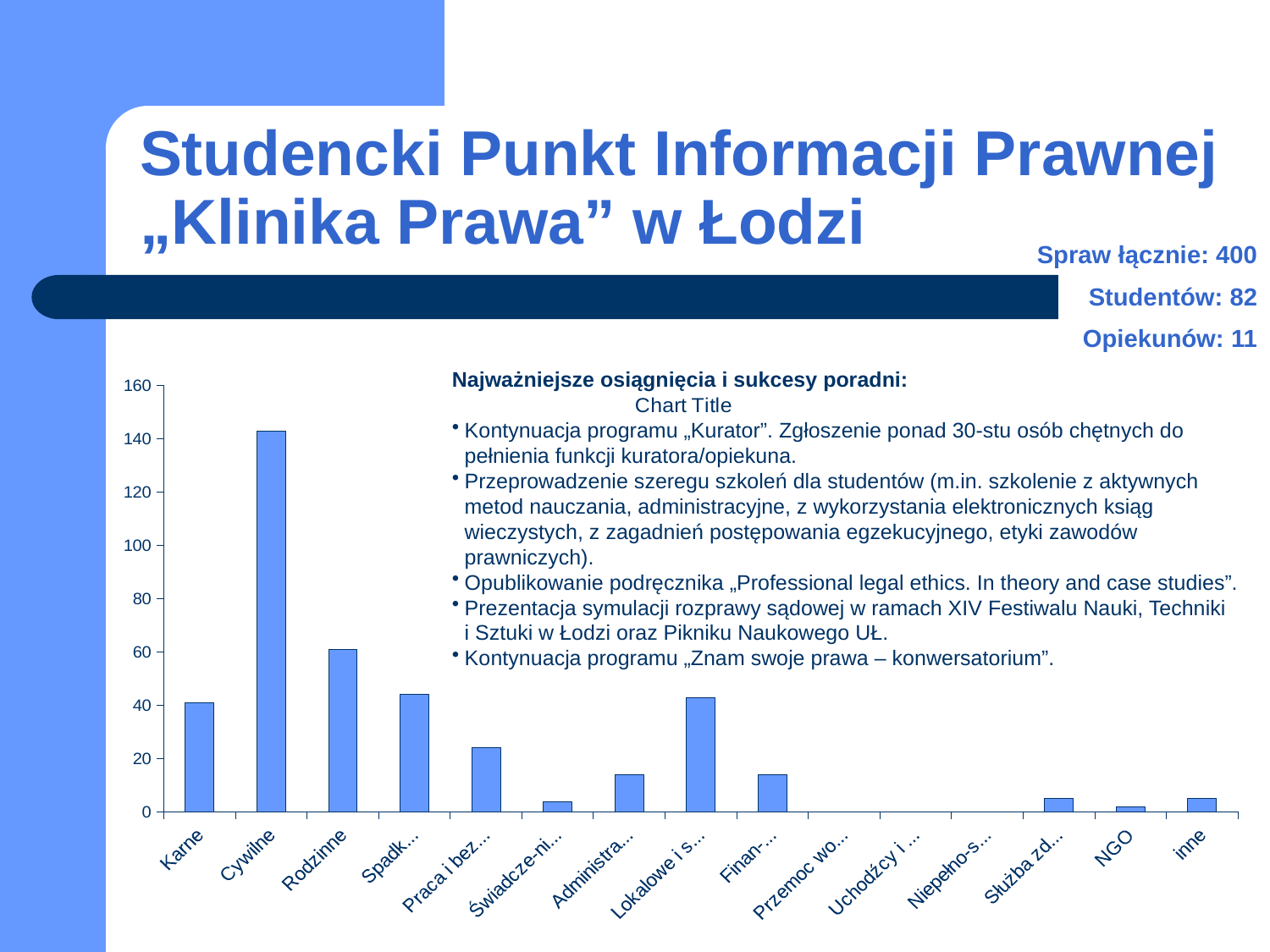
Is the value for Praca i bez... greater or less than 40? less Which is larger, the value for Rodzinne or the value for Karne? Rodzinne Which is larger, the value for Spadk... or the value for Praca i bez...? Spadk... Is the value for Rodzinne greater or less than 40? greater What kind of chart is shown on the slide? bar chart Is the value for Karne greater or less than 60? less How many categories are shown on the x axis of the chart? 15 What is the title shown above the chart? Chart Title Which category has the highest bar in the chart? Cywilne Which is larger, the value for Cywilne or the value for Rodzinne? Cywilne